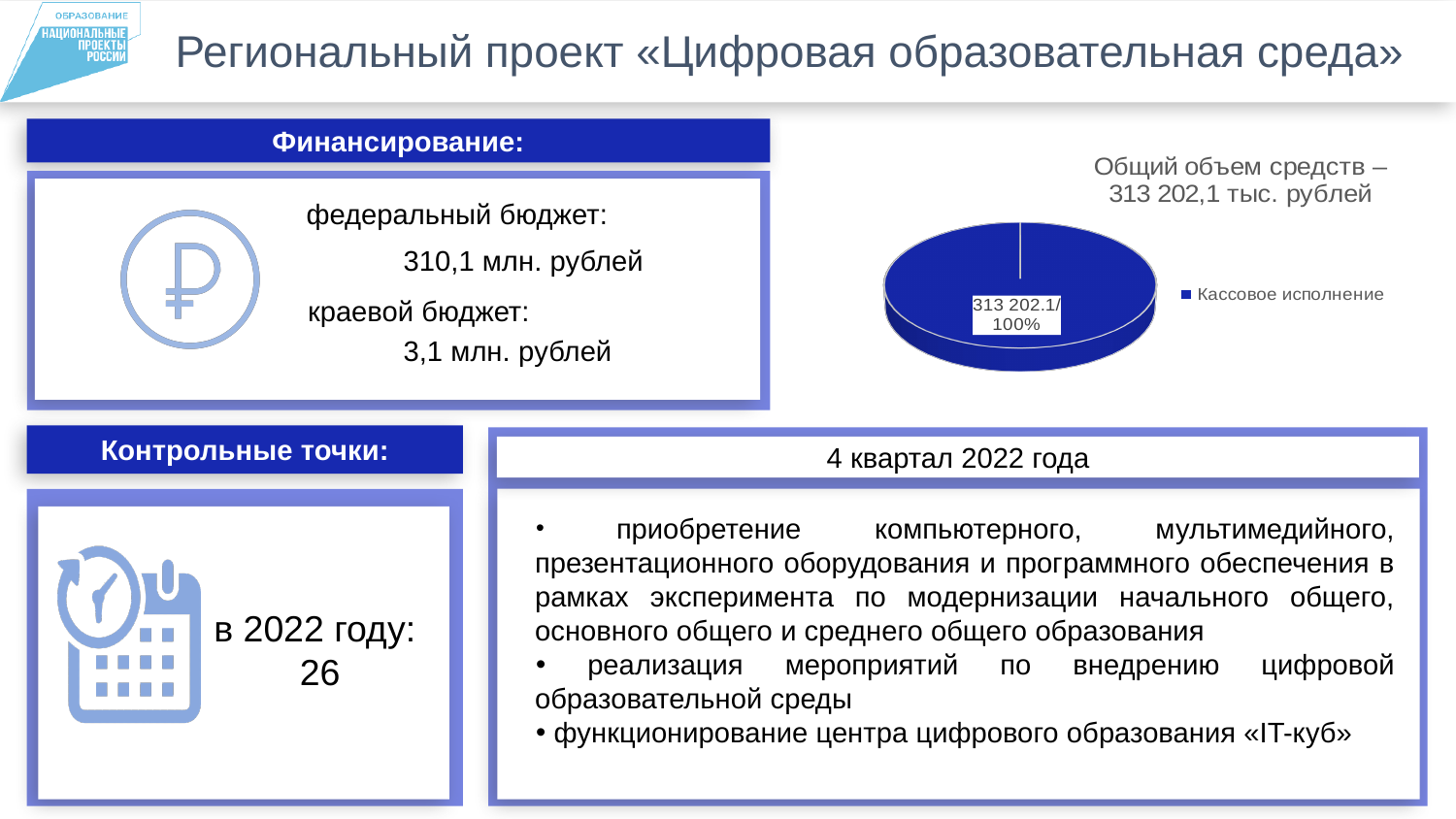
What share of the pie does the slice "Кассовое исполнение" take? 100% What kind of chart is shown on the slide? pie chart How many series does the chart legend list? 1 What is the legend entry of the pie chart? Кассовое исполнение What is the title of the pie chart? Общий объем средств – 313 202,1 тыс. рублей How many slices does the pie chart have? 1 What value is printed on the pie slice for "Кассовое исполнение"? 313 202.1